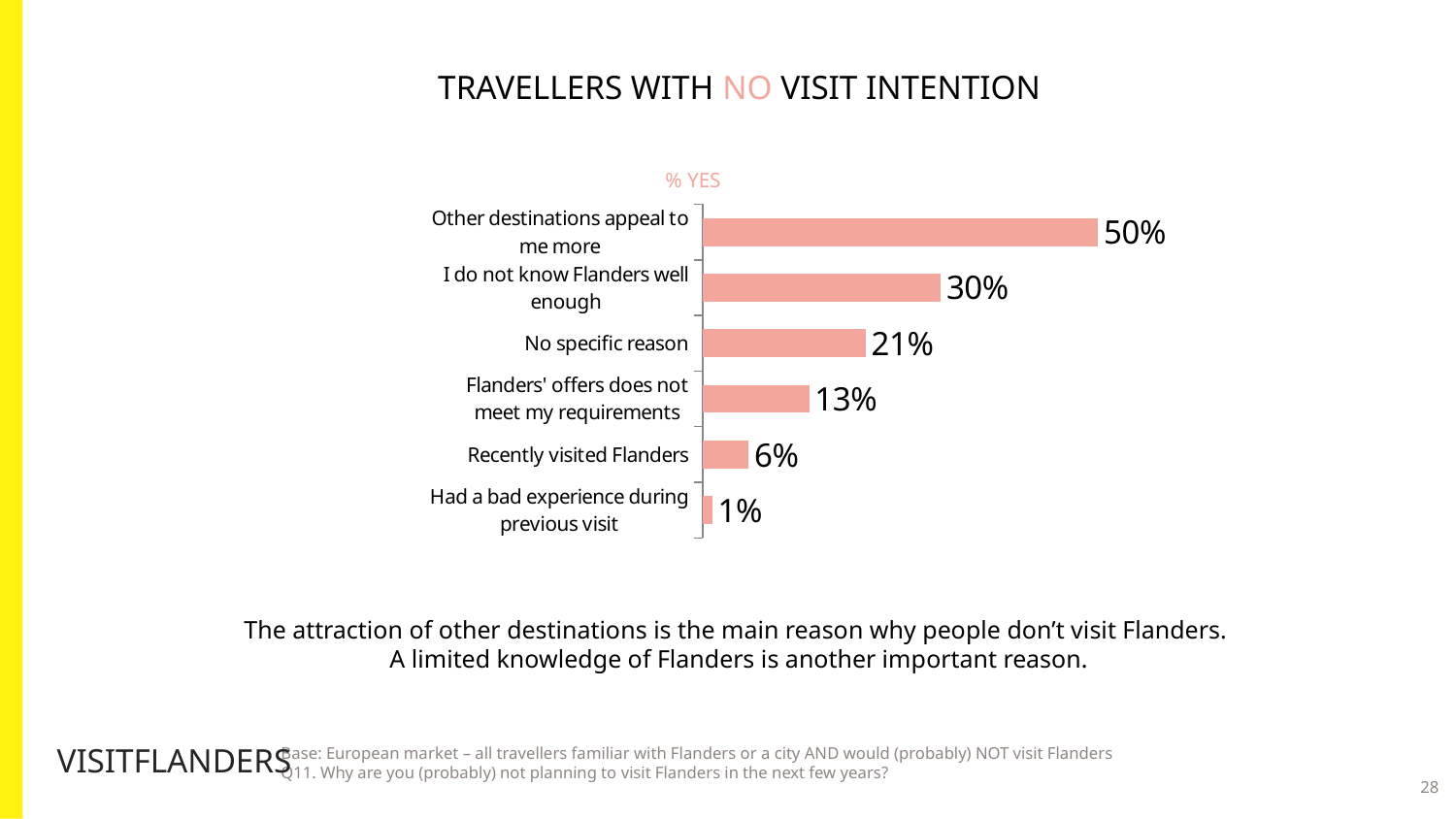
What is the value for 'Had a bad experience during previous visit'? 1% How many reasons are shown in the chart? 6 Which reason has the highest percentage? Other destinations appeal to me more What is the value for 'No specific reason'? 21% What is the value for 'I do not know Flanders well enough'? 30% What is the difference between 'Other destinations appeal to me more' and 'I do not know Flanders well enough'? 20% Which is larger: 'Recently visited Flanders' or 'No specific reason'? No specific reason What type of chart is shown on the slide? Bar chart What is the label shown above the chart indicating what the values represent? % YES Which reason has the lowest percentage? Had a bad experience during previous visit What percentage of travellers with no visit intention said 'Other destinations appeal to me more'? 50% What is the value for 'Flanders' offers does not meet my requirements'? 13%